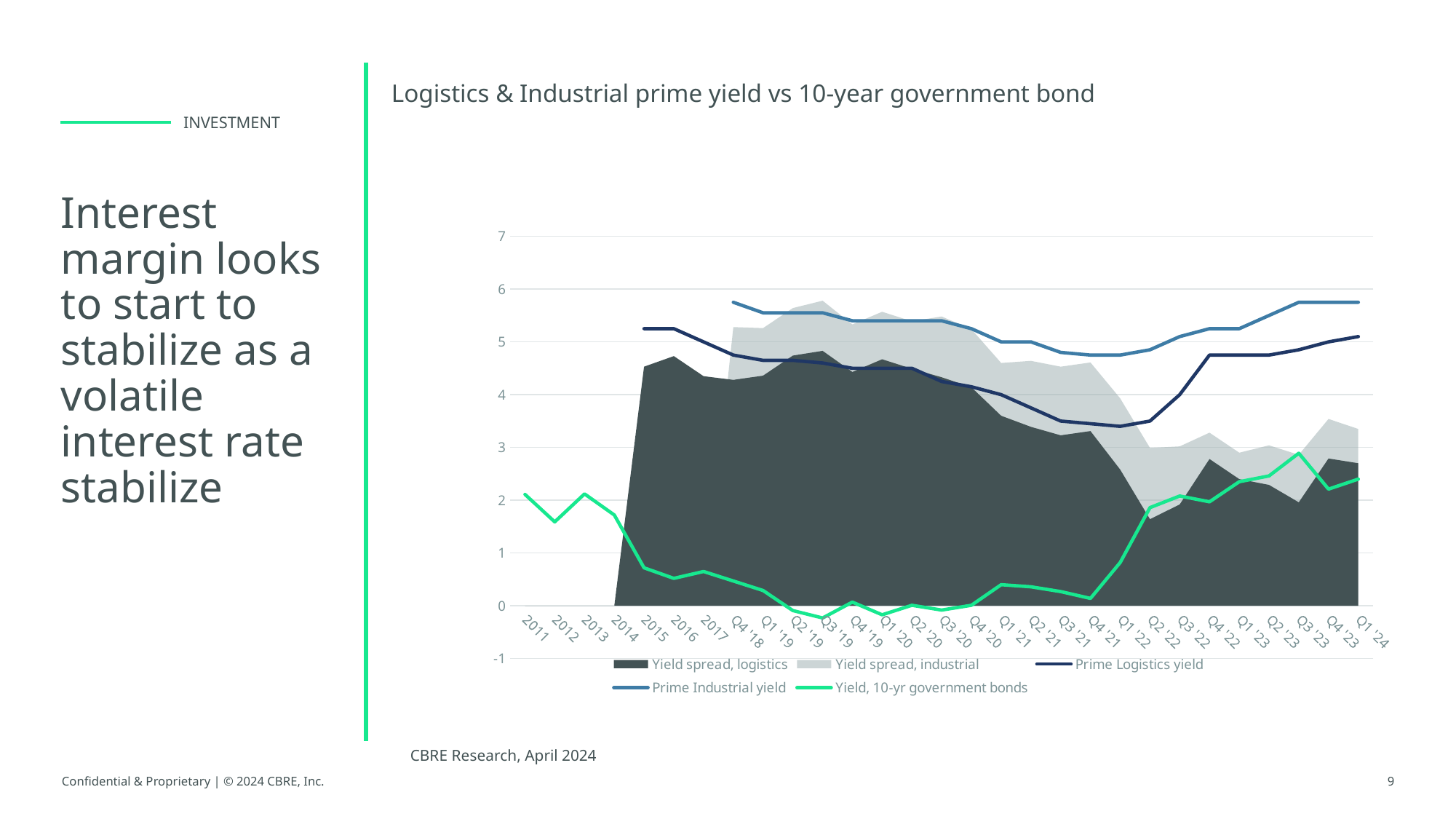
What is the title of the chart? Logistics & Industrial prime yield vs 10-year government bond Is the Yield, 10-yr government bonds at Q4 '21 greater or less than 1? less What source is cited below the chart? CBRE Research, April 2024 Is the Yield, 10-yr government bonds at Q3 '19 greater or less than 0? less How many series does the chart's legend list? 5 Is the Prime Industrial yield at Q1 '24 greater or less than 5? greater Does the Yield, 10-yr government bonds rise or fall from 2011 to 2014? fall What kind of chart is shown on the slide? combination area and line chart Does the Prime Industrial yield rise or fall from Q1 '22 to Q1 '24? rise How many time periods are labelled along the x axis of the chart? 29